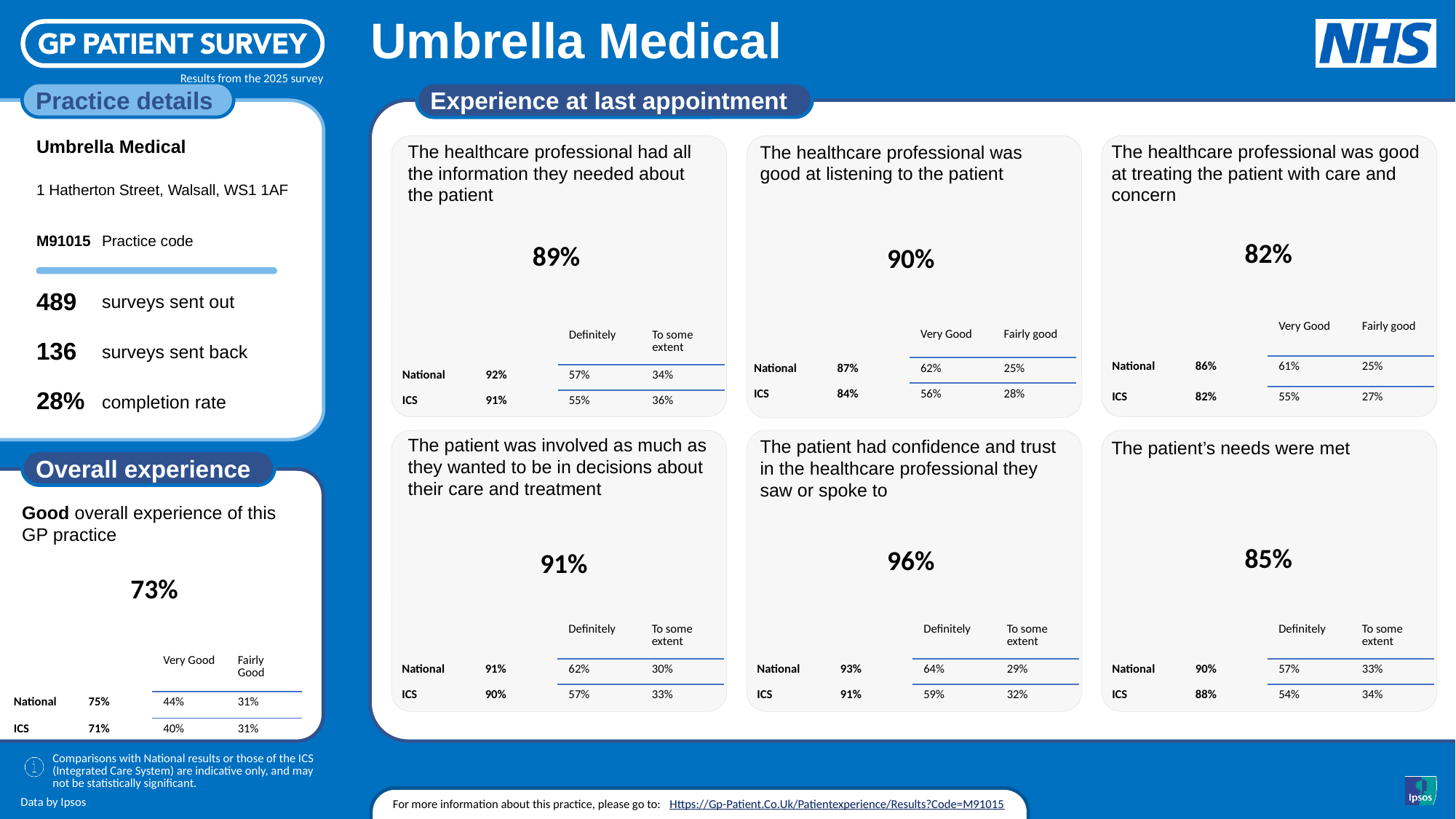
In the 'Overall experience' panel, what is the ICS 'Very Good' percentage? 40% How many statement panels are shown in the 'Experience at last appointment' section? 6 In the 'Experience at last appointment' section, what is the practice's percentage for 'The healthcare professional was good at listening to the patient'? 90% In the 'Experience at last appointment' section, which of the six statements has the highest practice percentage? The patient had confidence and trust in the healthcare professional they saw or spoke to In the panel 'The healthcare professional was good at treating the patient with care and concern', what is the ICS 'Fairly good' percentage? 27% In the 'Overall experience' panel, what percentage of patients reported a good overall experience of this GP practice? 73% In the panel 'The patient had confidence and trust in the healthcare professional they saw or spoke to', is the practice percentage higher or lower than the National percentage? higher In the panel 'The healthcare professional had all the information they needed about the patient', what is the National 'Definitely' percentage? 57% In the 'Overall experience' panel, what is the National percentage for good overall experience? 75% In the panel 'The patient was involved as much as they wanted to be in decisions about their care and treatment', what is the difference between the practice percentage and the ICS percentage? 1 percentage point In the panel 'The patient's needs were met', what is the difference between the practice percentage and the ICS percentage? -3 percentage points In the 'Experience at last appointment' section, which of the six statements has the lowest practice percentage? The healthcare professional was good at treating the patient with care and concern